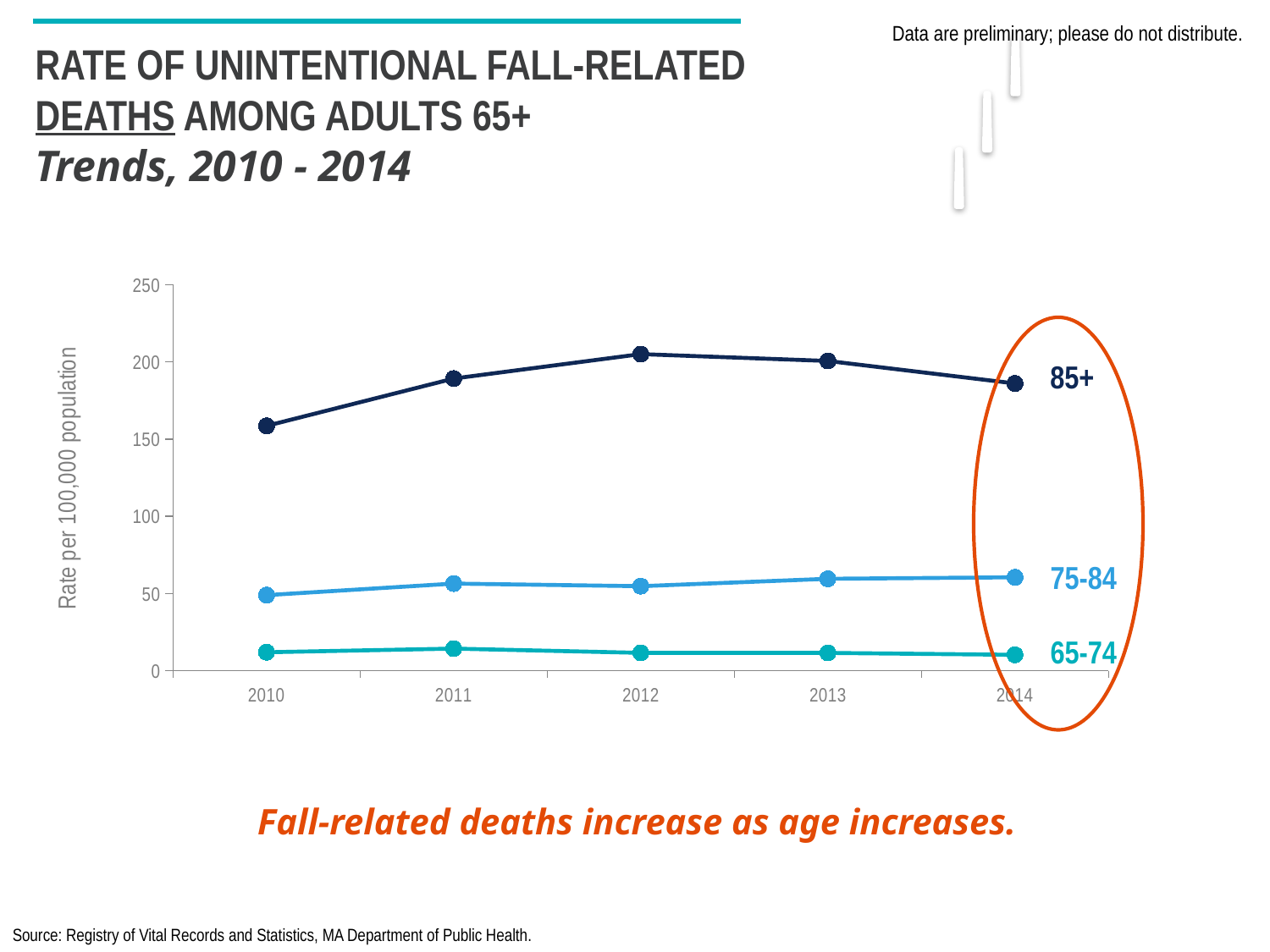
Which age group has the highest fall-related death rate across all years? 85+ What kind of chart is shown on the slide? line chart Does the rate for the 85+ group rise or fall from 2010 to 2012? rise Which age group has the lowest fall-related death rate across all years? 65-74 In which year is the rate for the 85+ group lowest? 2010 What is the label of the y axis? Rate per 100,000 population How many age-group series are plotted on the chart? 3 Is the rate for the 85+ group in 2014 greater or less than 200? less How many years are shown along the x axis? 5 Is the rate for the 85+ group in 2010 greater or less than 150? greater Is the rate for the 65-74 group in 2013 greater or less than 50? less